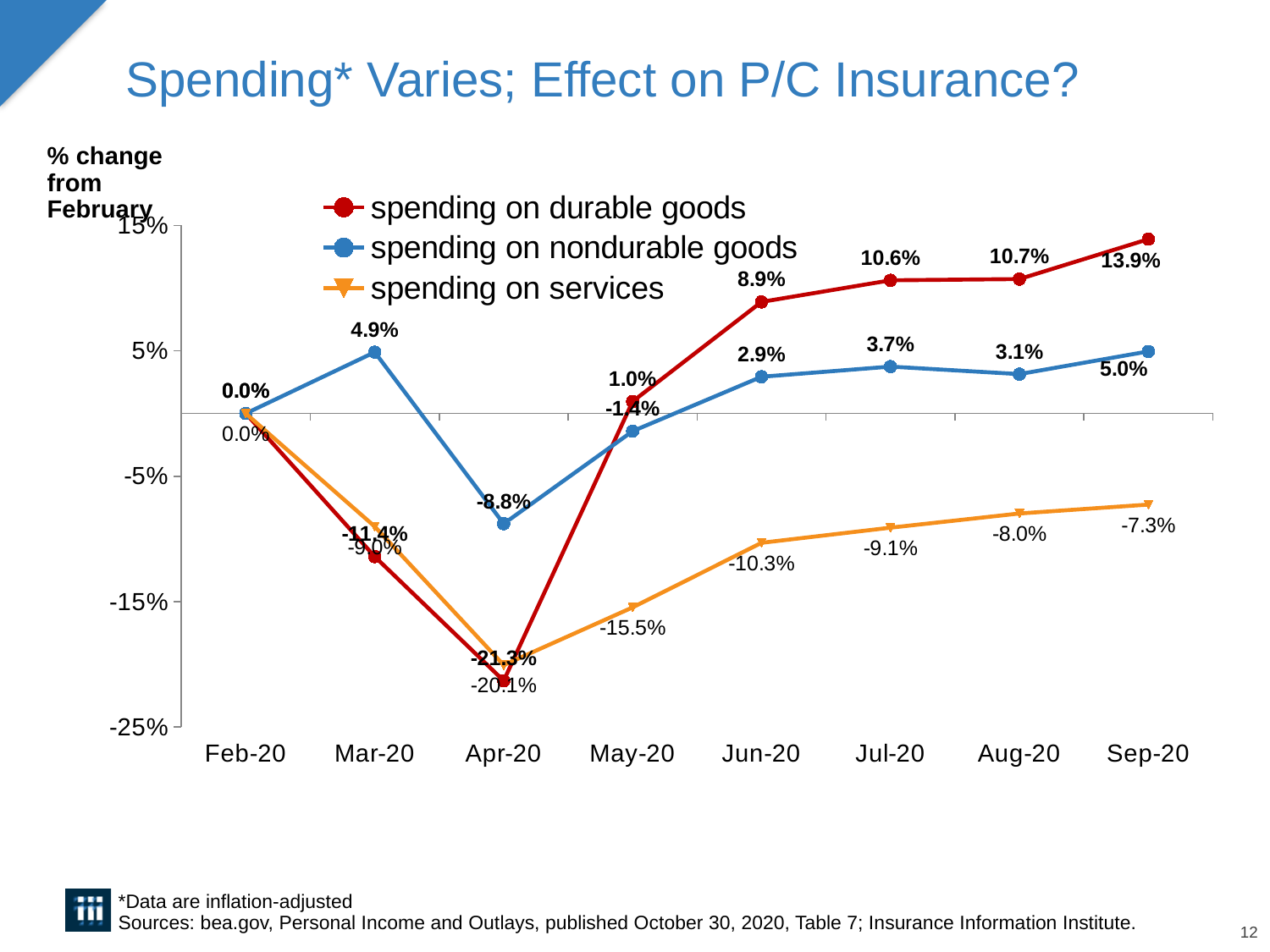
What kind of chart is shown on the slide? line chart In Aug-20, which is larger: spending on durable goods or spending on nondurable goods? spending on durable goods What is the difference between spending on durable goods and spending on nondurable goods in Jul-20? 6.9 percentage points What is the value for spending on durable goods in Sep-20? 13.9% Does spending on services rise or fall from Apr-20 to Sep-20? rise What colour is the line for spending on services? orange How many months are plotted along the x axis? 8 In which month is spending on durable goods highest? Sep-20 In which month is spending on services lowest? Apr-20 What is the value for spending on services in Jun-20? -10.3% What is the value for spending on nondurable goods in Apr-20? -8.8% How many series does the legend list? 3